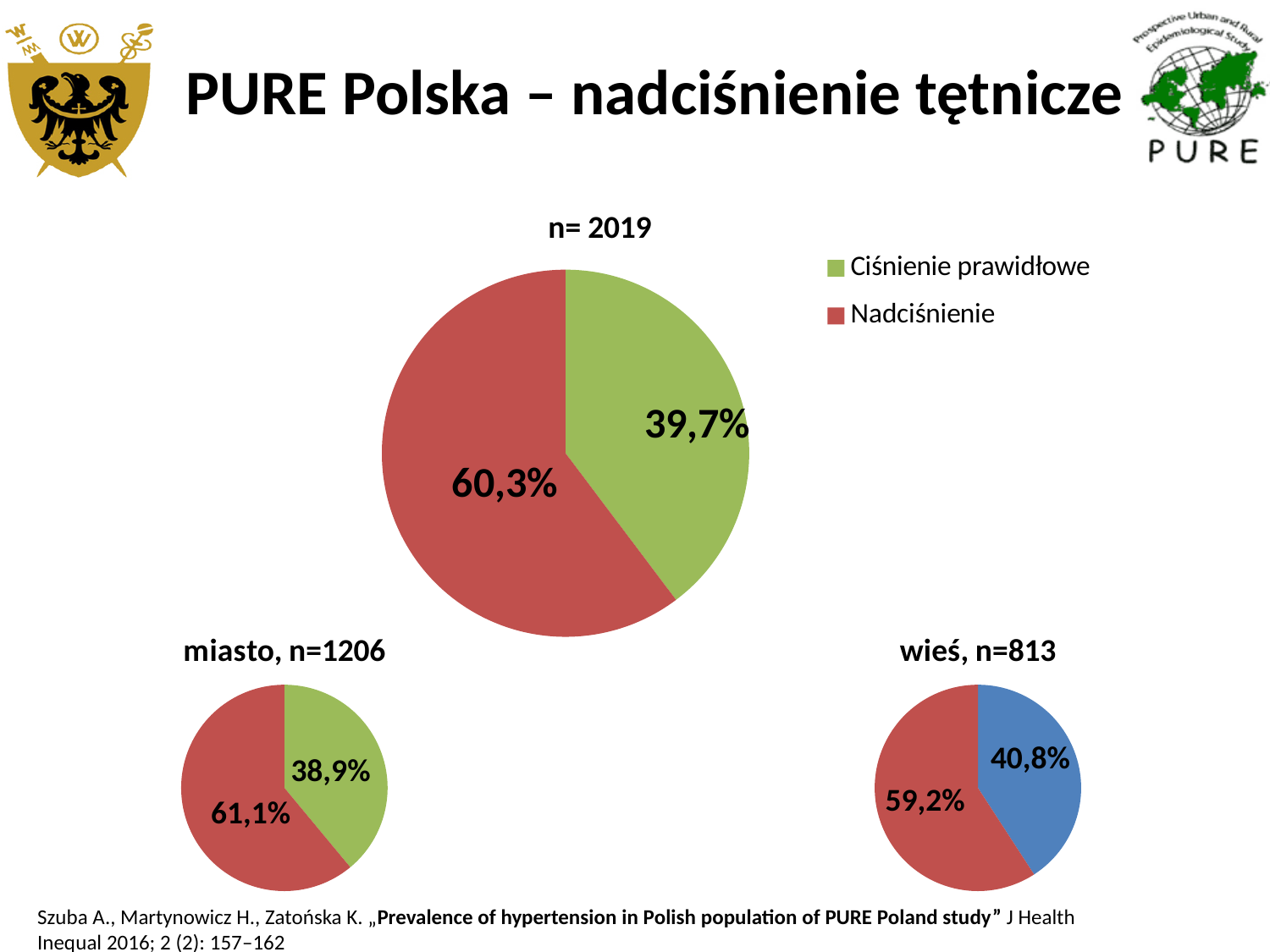
How many pie charts are shown on the slide? 3 In the chart titled "n= 2019", which category has the larger slice? Nadciśnienie In the chart titled "wieś, n=813", what value is shown for the blue slice? 40,8% In the chart titled "miasto, n=1206", what value is shown for the red slice? 61,1% In the chart titled "wieś, n=813", what value is shown for the red slice? 59,2% How many entries does the legend list? 2 In the chart titled "n= 2019", what share of the pie is labelled Nadciśnienie? 60,3% Which is larger: the red slice in the "miasto, n=1206" chart or the red slice in the "wieś, n=813" chart? miasto, n=1206 In the chart titled "n= 2019", what is the difference between the Nadciśnienie and Ciśnienie prawidłowe shares? 20,6% In the chart titled "n= 2019", what share of the pie is labelled Ciśnienie prawidłowe? 39,7% In the chart titled "miasto, n=1206", what value is shown for the green slice? 38,9% What type of chart is used on this slide? Pie chart